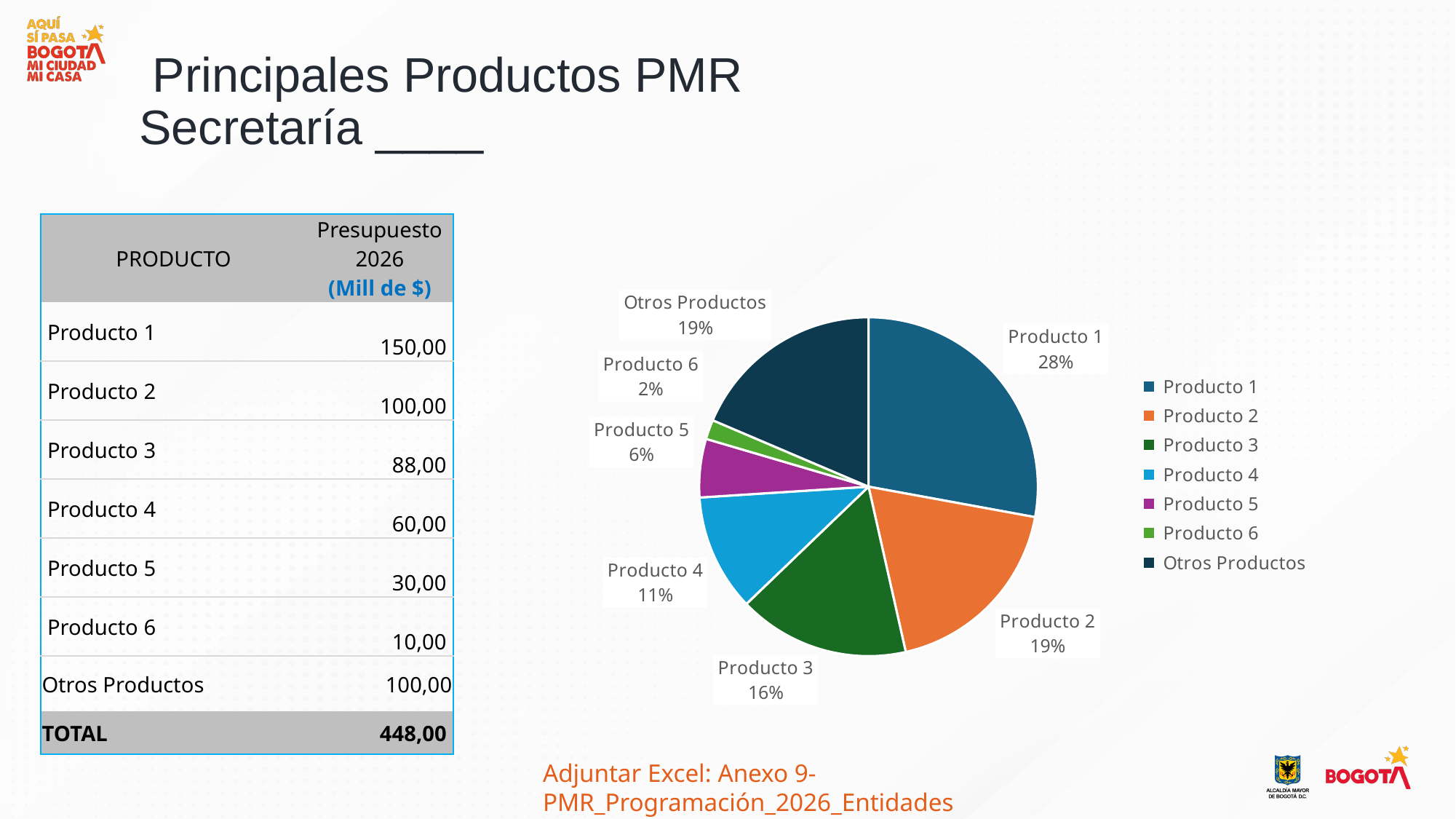
Which has a larger share in the pie chart, Producto 3 or Producto 4? Producto 3 What percentage is shown for Otros Productos in the pie chart? 19% What percentage is shown for Producto 4 in the pie chart? 11% What percentage is shown for Producto 5 in the pie chart? 6% Which slice of the pie chart is the smallest? Producto 6 How many entries does the pie chart legend list? 7 How many slices does the pie chart have? 7 What kind of chart is shown on the slide? pie chart By how many percentage points does Producto 1's share exceed Producto 2's share? 9 What share of the pie does Producto 1 represent? 28% Which colour is used for the Producto 2 slice in the pie chart? orange Which slice of the pie chart is the largest? Producto 1